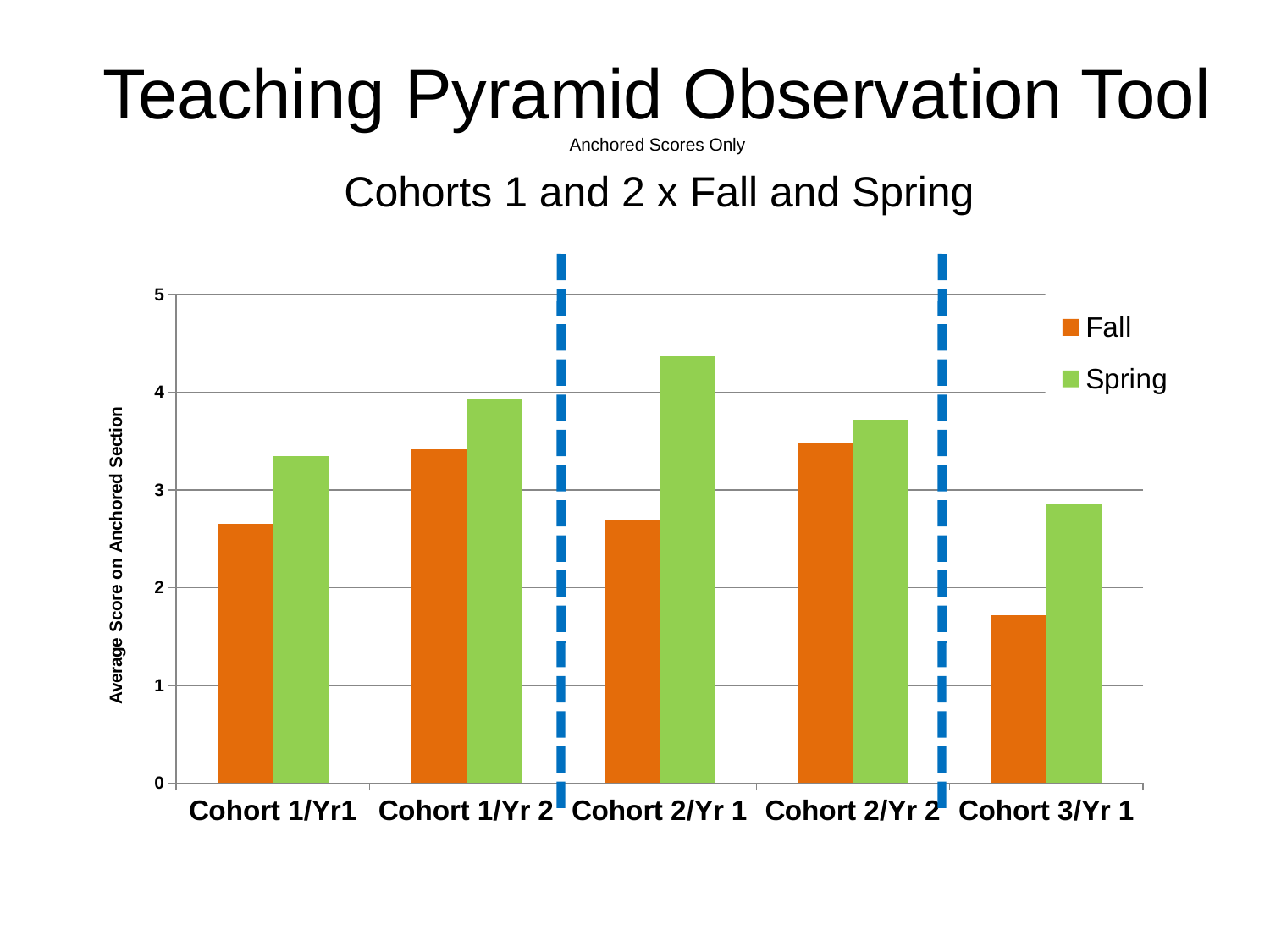
Is the Fall value for Cohort 1/Yr1 greater or less than 3? less How many series does the legend list? 2 Which category has the lowest Fall score? Cohort 3/Yr 1 Is the Fall value for Cohort 3/Yr 1 greater or less than 2? less How many cohort/year categories are shown on the x axis? 5 What is the title of the vertical axis? Average Score on Anchored Section Which category has the lowest Spring score? Cohort 3/Yr 1 What kind of chart is shown on the slide? bar chart Which is larger, the Fall score for Cohort 1/Yr1 or the Fall score for Cohort 3/Yr 1? Cohort 1/Yr1 Is the Spring value for Cohort 2/Yr 1 greater or less than 4? greater Which category has the highest Spring score? Cohort 2/Yr 1 For Cohort 2/Yr 1, which is larger, the Fall score or the Spring score? Spring